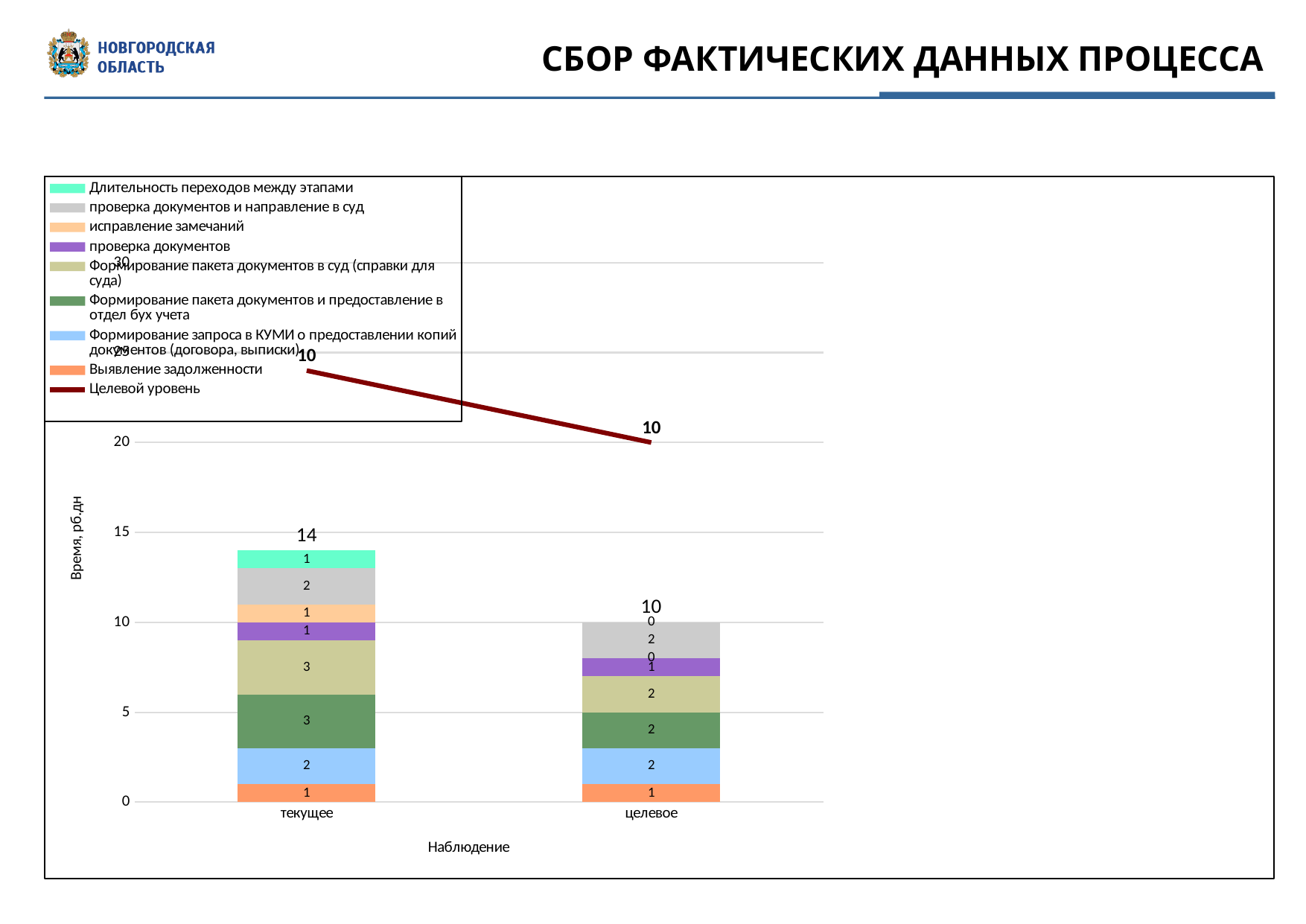
What is the value of the "Целевой уровень" line at "целевое"? 10 Which bar has the higher total, "текущее" or "целевое"? текущее What is the value of the "Формирование пакета документов в суд (справки для суда)" segment for "целевое"? 2 How many categories are shown on the x axis? 2 What is the difference between the totals of the "текущее" and "целевое" bars? 4 What is the label of the y axis? Время, рб,дн What is the value of the "Формирование запроса в КУМИ о предоставлении копий документов (договора, выписки)" segment for "целевое"? 2 What is the total of the stacked bar for "текущее"? 14 What is the value of the "Выявление задолженности" segment for "текущее"? 1 How many series does the legend list? 9 What is the total of the stacked bar for "целевое"? 10 What is the value of the "Формирование пакета документов и предоставление в отдел бух учета" segment for "текущее"? 3